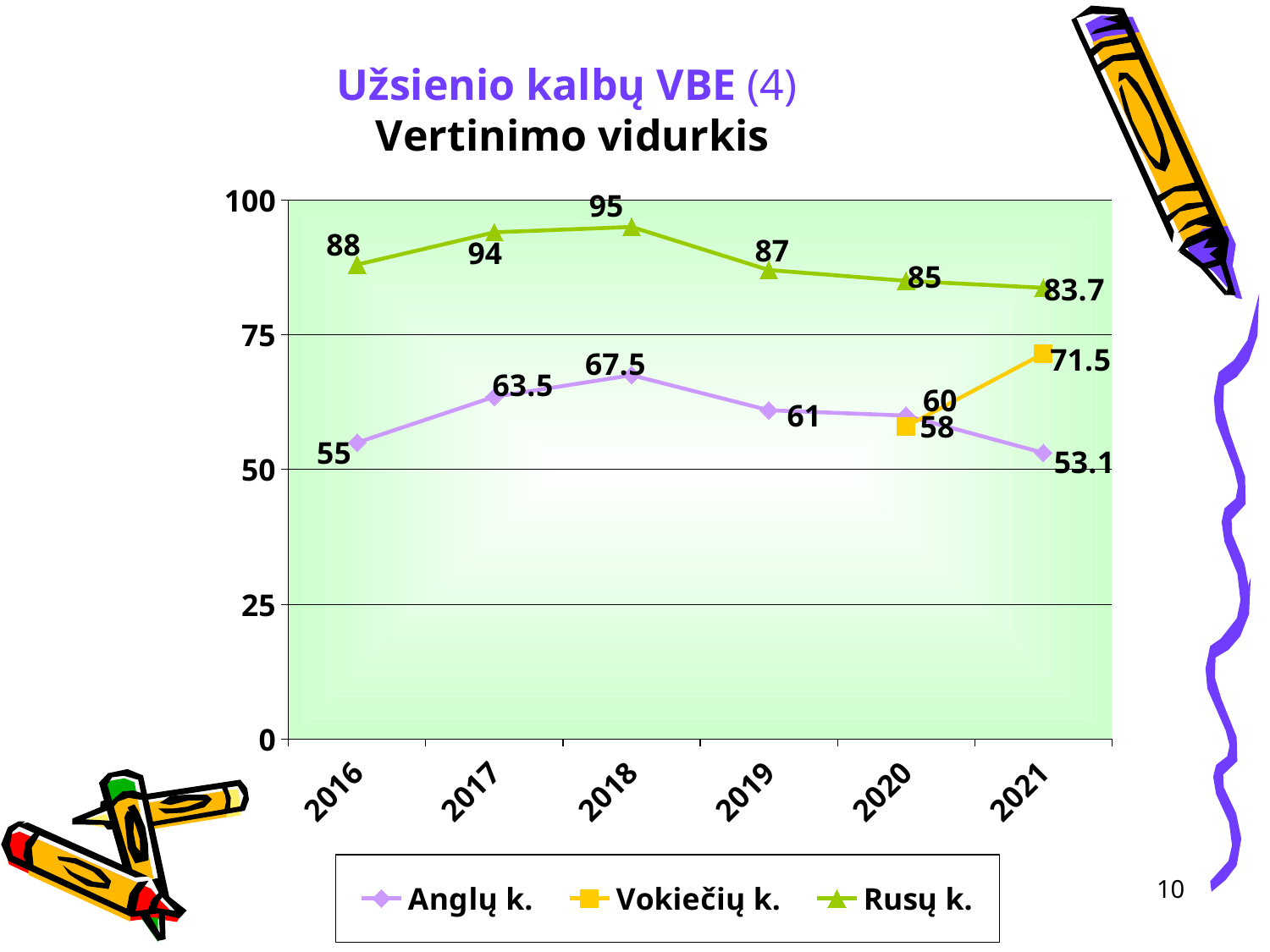
What is the value for Rusų k. in 2018? 95 How many series does the legend list? 3 In which year is the Rusų k. value lowest? 2021 What is the value for Anglų k. in 2021? 53.1 How many years are shown on the x axis? 6 Does the Anglų k. value rise or fall from 2018 to 2021? fall Is the value for Rusų k. in 2020 greater or less than 75? greater What is the value for Vokiečių k. in 2020? 58 Which is larger in 2021, the Vokiečių k. value or the Anglų k. value? Vokiečių k. What is the difference between the Rusų k. and Anglų k. values in 2016? 33 In which year is the Anglų k. value highest? 2018 What kind of chart is shown on the slide? line chart